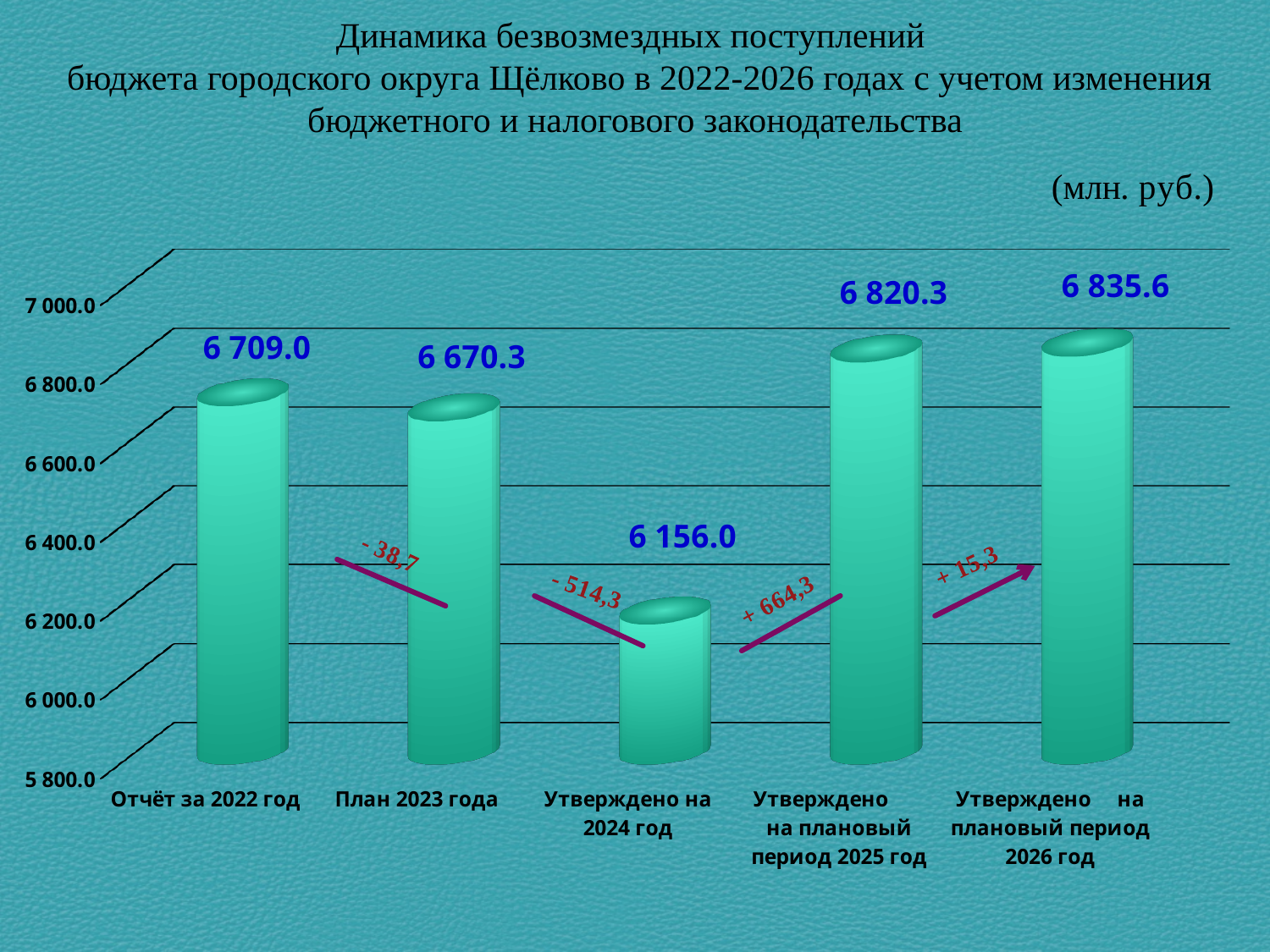
In what units are the values on the chart given? млн. руб. What is the difference between the value for «Отчёт за 2022 год» and the value for «План 2023 года»? 38.7 How many categories are shown on the chart? 5 What is the difference between the value for «Утверждено на плановый период 2025 год» and the value for «Утверждено на 2024 год»? 664.3 What is the value for «Утверждено на плановый период 2025 год»? 6 820.3 Which category has the highest value? Утверждено на плановый период 2026 год What is the value for «План 2023 года»? 6 670.3 What is the value for «Отчёт за 2022 год»? 6 709.0 What kind of chart is shown on the slide? Bar chart What is the value for «Утверждено на 2024 год»? 6 156.0 Which is larger: the value for «План 2023 года» or the value for «Утверждено на 2024 год»? План 2023 года Which category has the lowest value? Утверждено на 2024 год